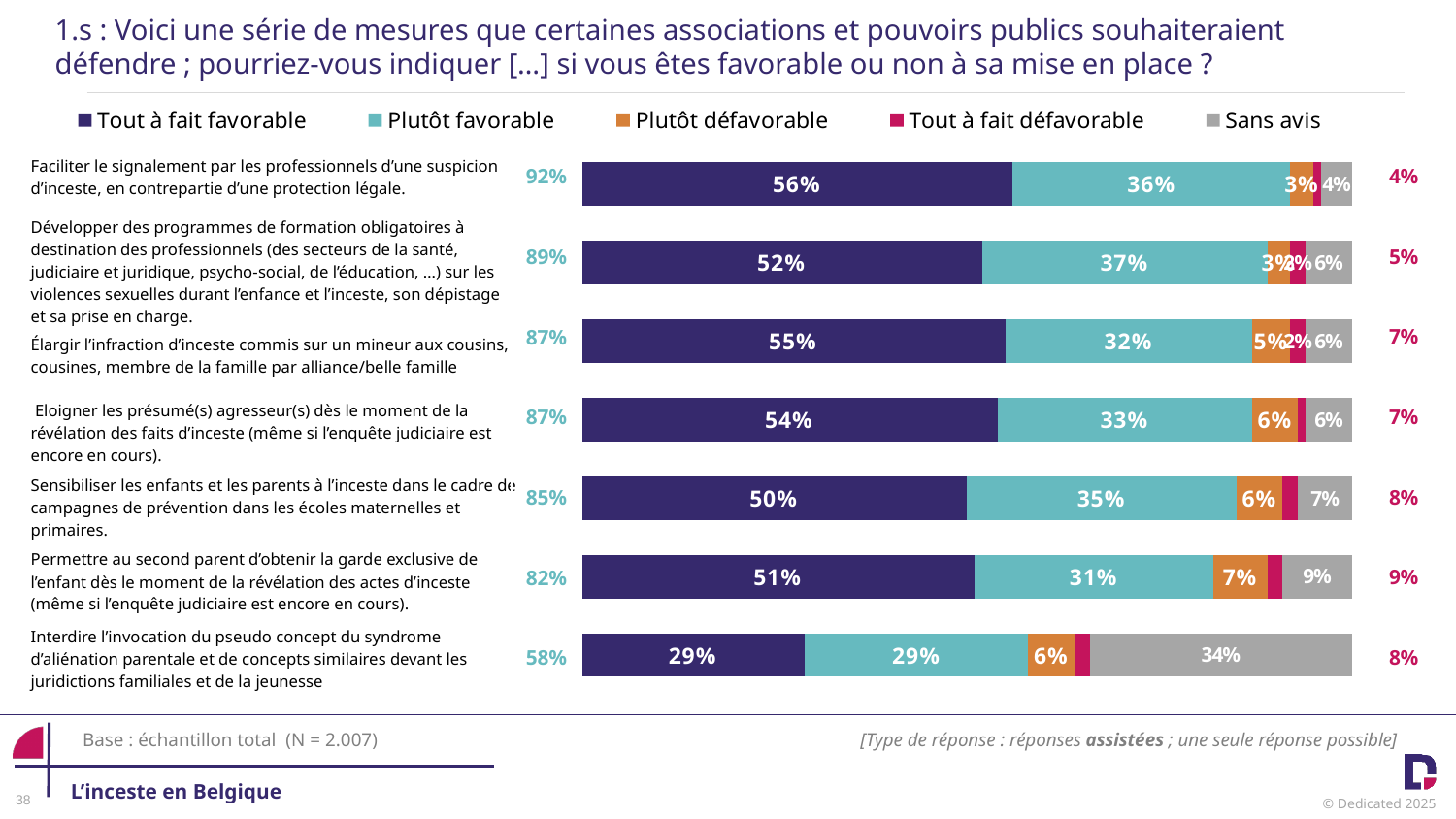
What is the difference in percentage points between the highest and lowest "Tout à fait favorable" values? 27 percentage points How many measures (bars) are shown in the chart? 7 What is the "Plutôt défavorable" value for "Permettre au second parent d'obtenir la garde exclusive de l'enfant dès le moment de la révélation des actes d'inceste"? 7% Which legend entry is shown in dark purple? Tout à fait favorable Which has the larger "Plutôt favorable" value: "Développer des programmes de formation obligatoires" or "Élargir l'infraction d'inceste commis sur un mineur aux cousins, cousines"? Développer des programmes de formation obligatoires What kind of chart is shown on the slide? Stacked bar chart Which measure has the highest "Tout à fait favorable" share? Faciliter le signalement par les professionnels d'une suspicion d'inceste, en contrepartie d'une protection légale What percentage of respondents are "Tout à fait favorable" to "Faciliter le signalement par les professionnels d'une suspicion d'inceste, en contrepartie d'une protection légale"? 56% How many series does the legend list? 5 What is the "Sans avis" value for "Interdire l'invocation du pseudo concept du syndrome d'aliénation parentale et de concepts similaires devant les juridictions familiales et de la jeunesse"? 34% What is the "Plutôt favorable" value for "Sensibiliser les enfants et les parents à l'inceste dans le cadre de campagnes de prévention dans les écoles maternelles et primaires"? 35% Which measure has the lowest "Tout à fait favorable" share? Interdire l'invocation du pseudo concept du syndrome d'aliénation parentale et de concepts similaires devant les juridictions familiales et de la jeunesse